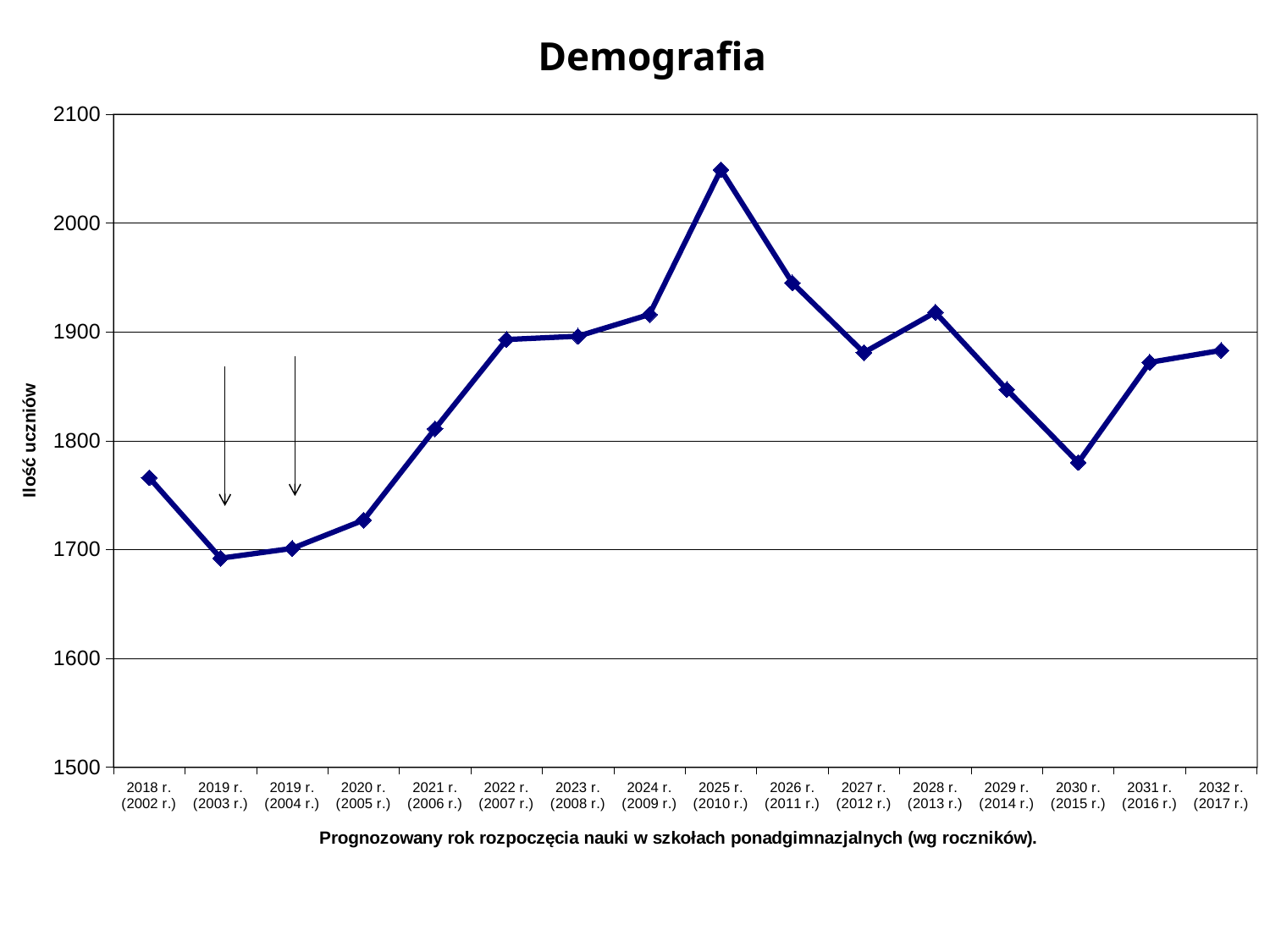
What is the label on the vertical axis of the chart? Ilość uczniów Is the value for 2029 r. (2014 r.) greater or less than 1900? less What kind of chart is shown on the slide? line chart What is the title of the chart? Demografia Do the values rise or fall from 2019 r. (2004 r.) to 2025 r. (2010 r.)? rise How many data points are plotted on the line? 16 Is the value for 2020 r. (2005 r.) greater or less than 1700? greater Is the value for 2025 r. (2010 r.) greater or less than 2000? greater Which is larger, the value for 2025 r. (2010 r.) or the value for 2026 r. (2011 r.)? 2025 r. (2010 r.) Which category has the highest value on the chart? 2025 r. (2010 r.) Which is larger, the value for 2031 r. (2016 r.) or the value for 2030 r. (2015 r.)? 2031 r. (2016 r.)